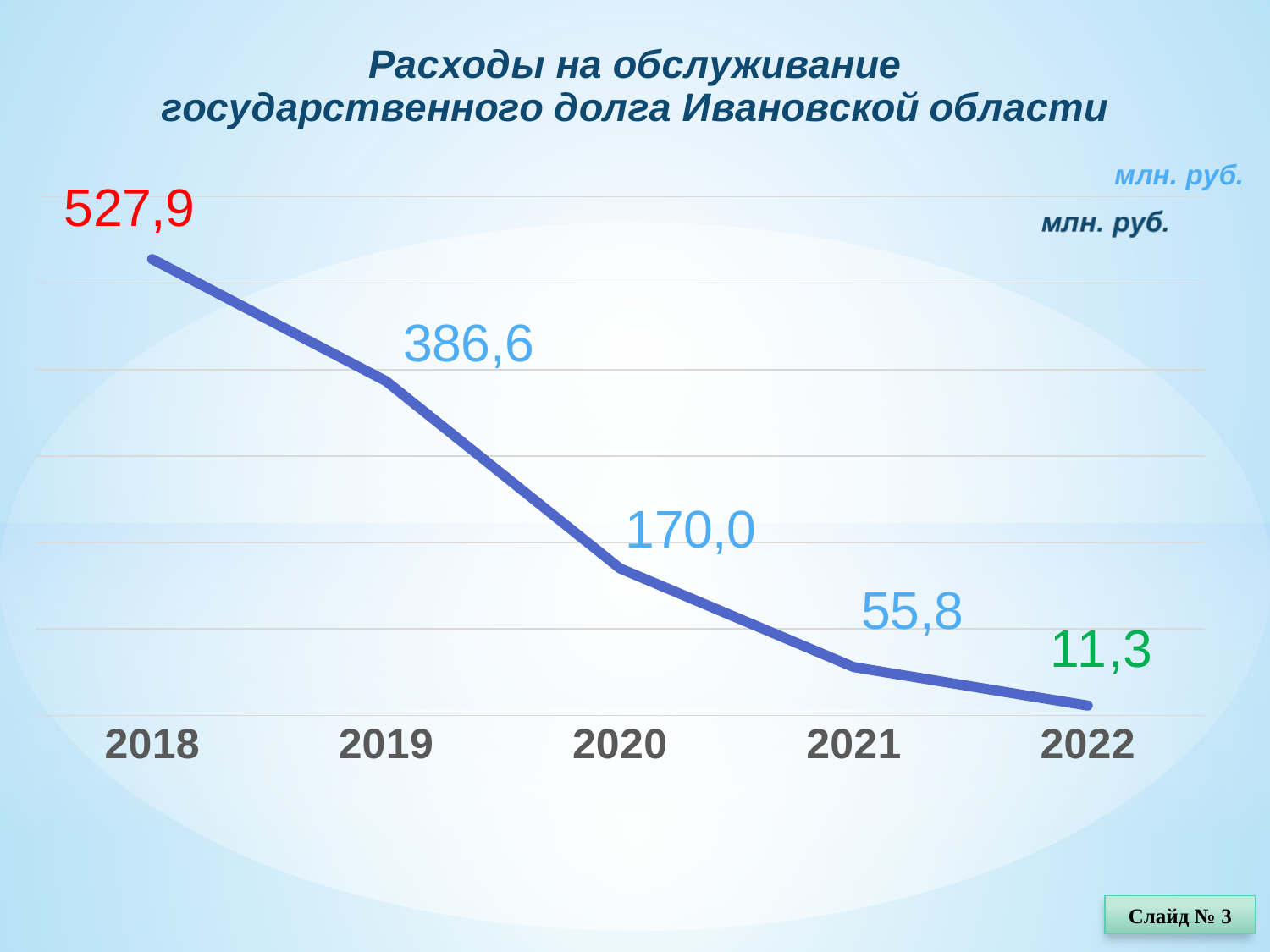
What is the value for 2020? 170,0 What is the difference between the values for 2021 and 2022? 44,5 Which is larger, the value for 2019 or the value for 2020? 2019 Do the values rise or fall from 2018 to 2022? fall What kind of chart is shown? line chart Which year has the lowest value? 2022 What is the value for 2021? 55,8 How many years are plotted on the chart? 5 What is the value for 2022? 11,3 What is the value for 2018? 527,9 What is the difference between the values for 2018 and 2019? 141,3 Which year has the highest value? 2018